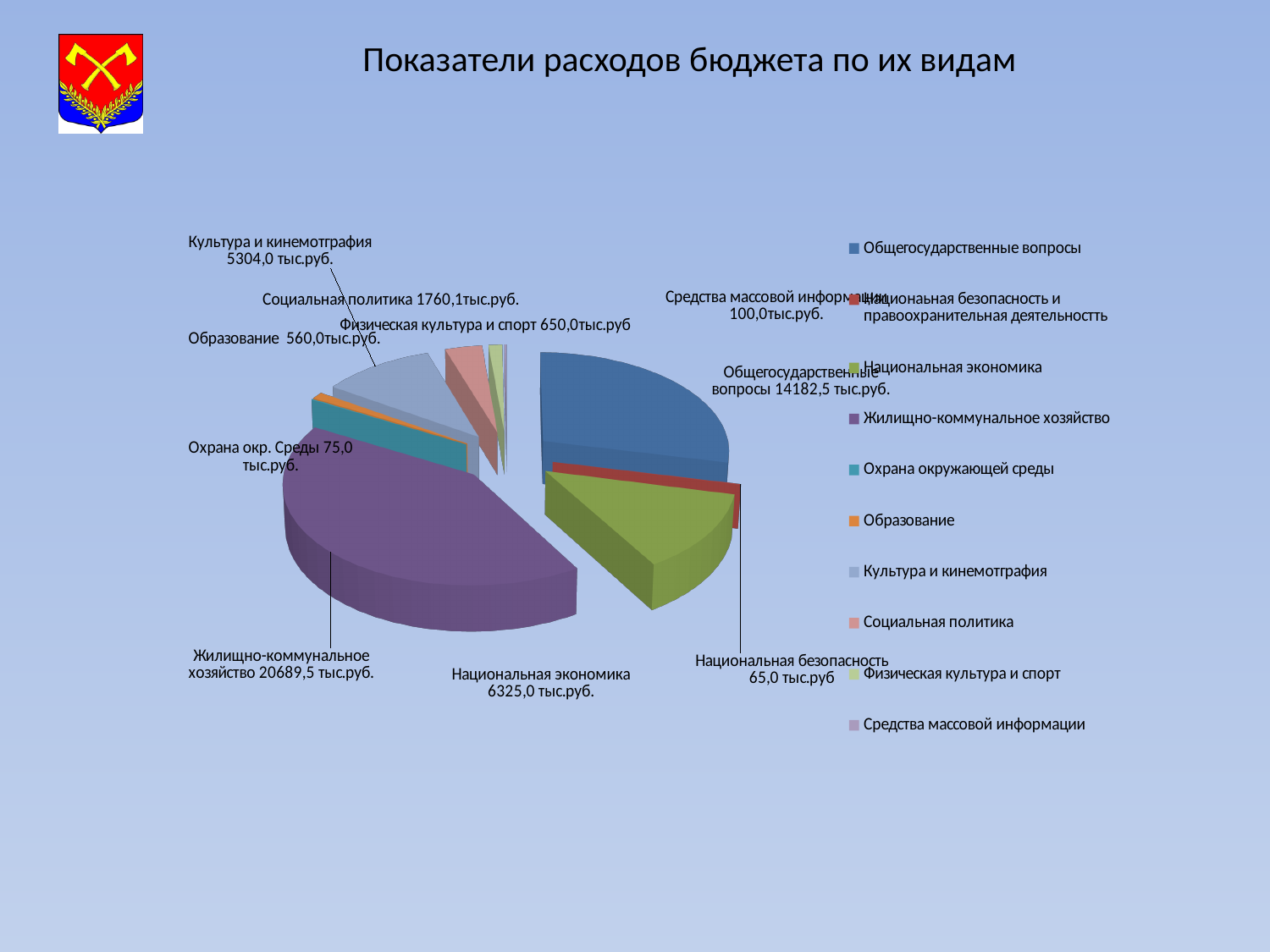
What is the value shown for Национальная безопасность? 65,0 тыс.руб What is the value shown for Национальная экономика? 6325,0 тыс.руб. Which category has the largest value in the pie chart? Жилищно-коммунальное хозяйство What is the difference between the values for Жилищно-коммунальное хозяйство and Общегосударственные вопросы? 6507,0 тыс.руб. Which category has the smallest value in the pie chart? Национальная безопасность Which is larger, the value for Физическая культура и спорт or the value for Образование? Физическая культура и спорт What is the value shown for Общегосударственные вопросы? 14182,5 тыс.руб. What is the value shown for Социальная политика? 1760,1 тыс.руб. What is the value shown for Культура и кинемотграфия? 5304,0 тыс.руб. How many entries does the legend list? 10 What is the value shown for Жилищно-коммунальное хозяйство? 20689,5 тыс.руб. What kind of chart is shown on the slide? Pie chart